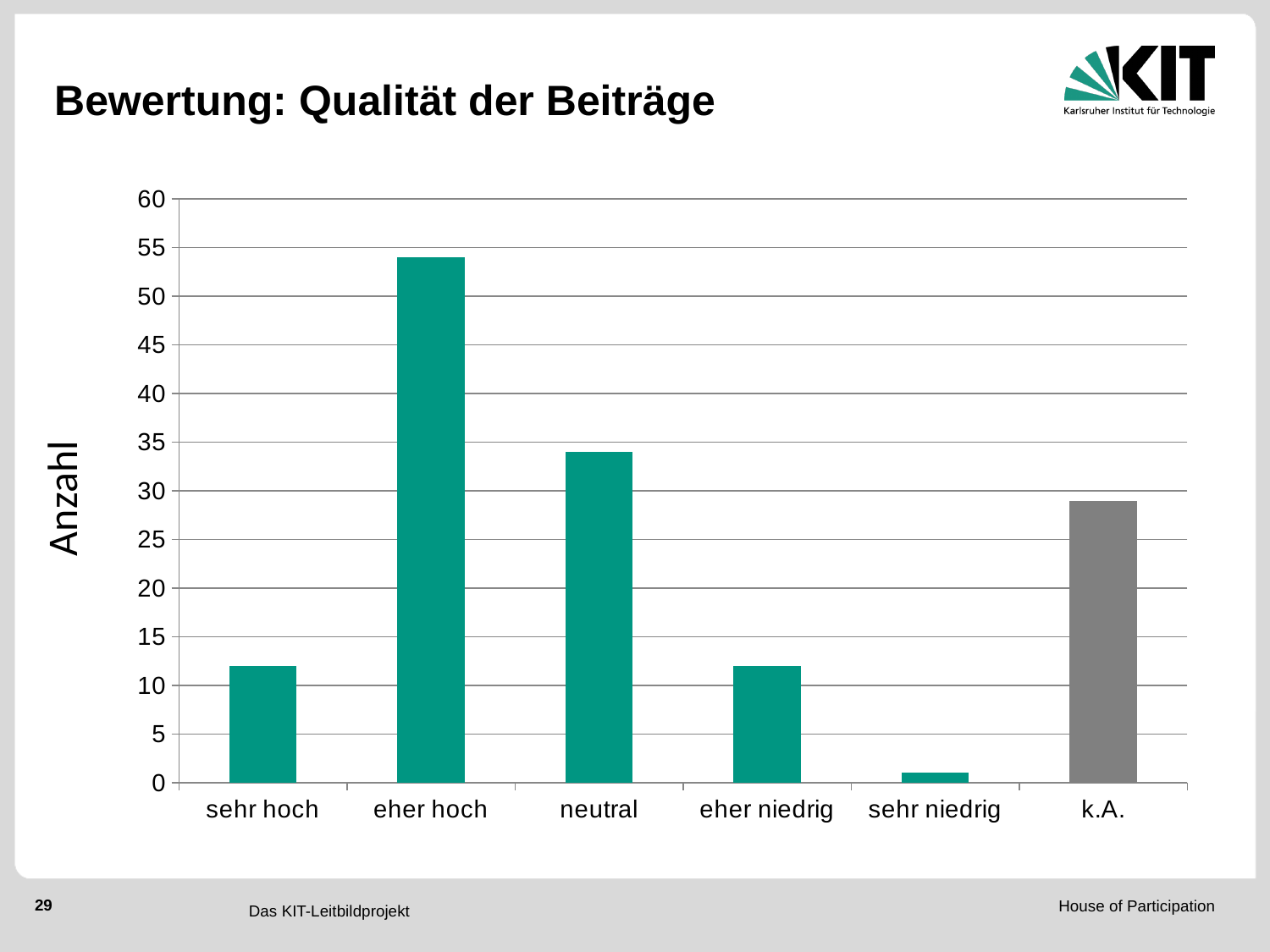
Which category has the lowest value in the chart? sehr niedrig Is the value for eher niedrig greater or less than 15? less What is the label of the vertical axis of the chart? Anzahl What kind of chart is shown on the slide? bar chart Which is larger, the value for neutral or the value for k.A.? neutral How many categories are shown on the x axis of the chart? 6 Is the value for sehr niedrig greater or less than 5? less Is the value for neutral greater or less than 30? greater What is the title of the slide containing the chart? Bewertung: Qualität der Beiträge Which is larger, the value for eher hoch or the value for neutral? eher hoch Which category has the highest value in the chart? eher hoch